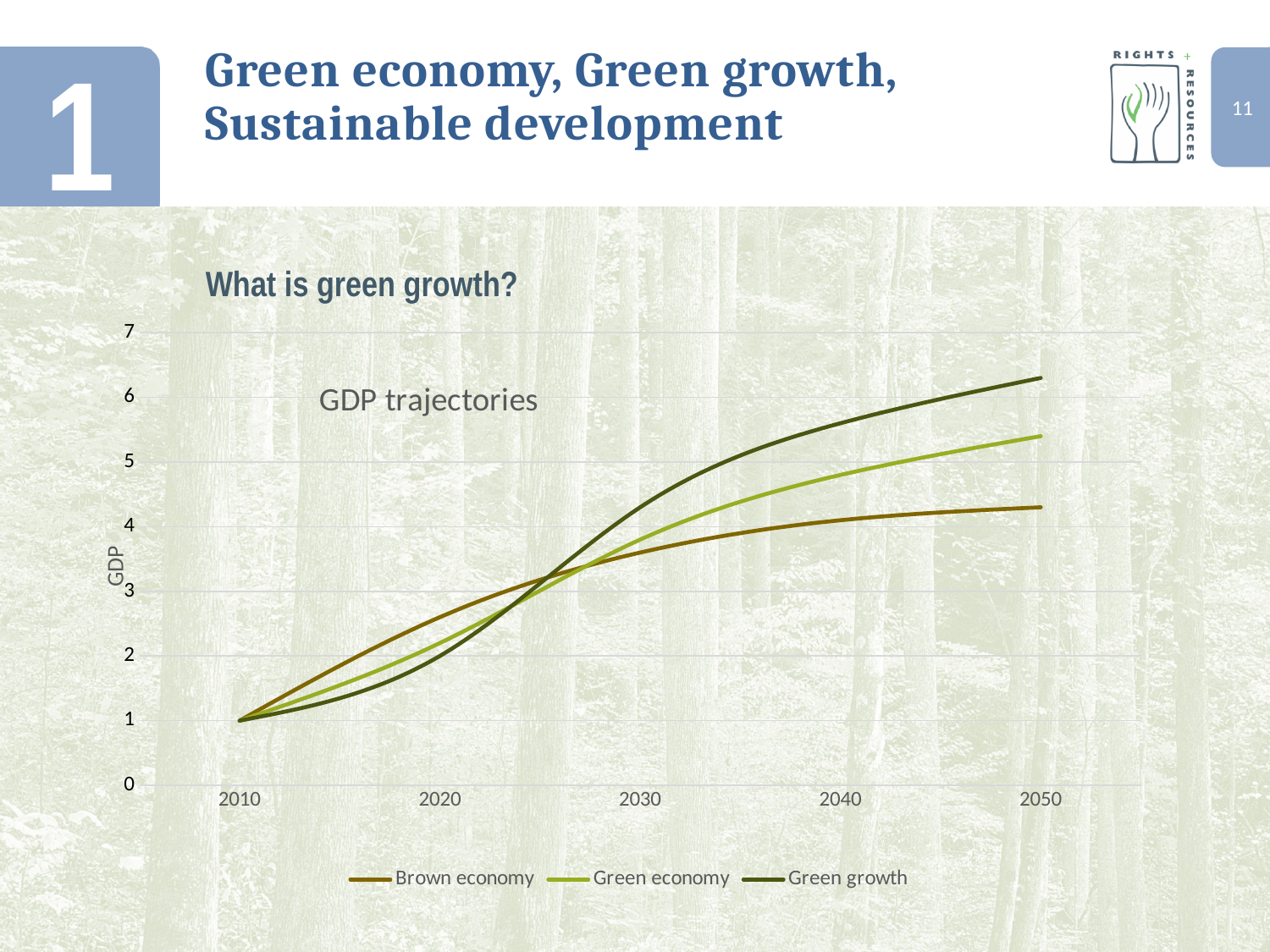
What is the title of the chart? GDP trajectories What are the three series named in the legend? Brown economy, Green economy, Green growth Is the GDP value for Green economy in 2050 greater or less than 5? greater In 2020, which series has the larger GDP value, Brown economy or Green growth? Brown economy Which series has the highest GDP value in 2050? Green growth Does the Green growth line rise or fall from 2010 to 2050? rise What kind of chart is shown on the slide? line chart How many year labels are shown on the x axis? 5 Is the GDP value for Brown economy in 2050 greater or less than 5? less Which series has the lowest GDP value in 2050? Brown economy Is the GDP value for Green growth in 2050 greater or less than 6? greater How many series does the legend list? 3